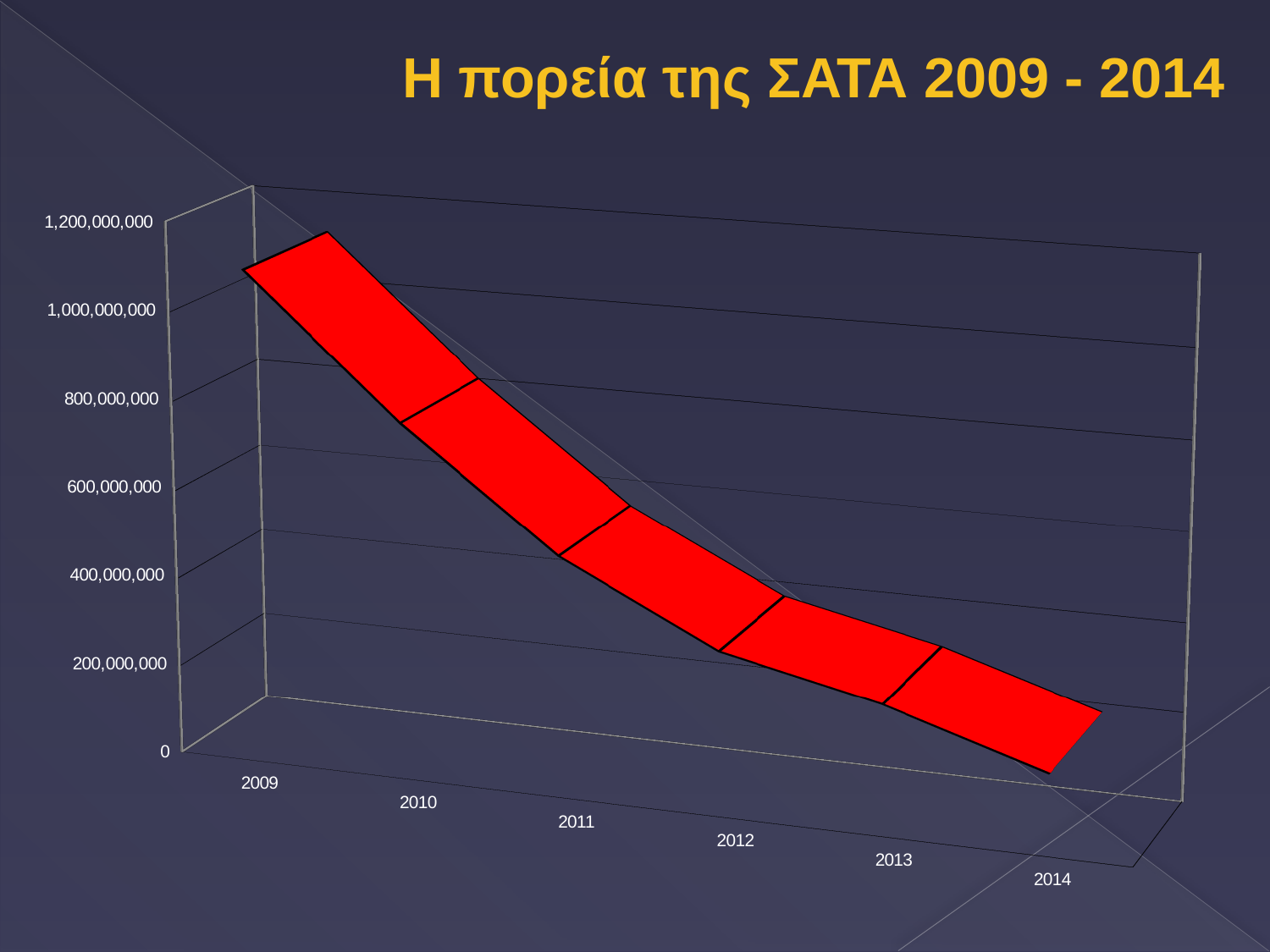
Is the value for 2012 greater or less than 600,000,000? less Which is larger, the value for 2010 or the value for 2013? 2010 Is the value for 2011 greater or less than 1,000,000,000? less Which year has the lowest value? 2014 Do the values rise or fall from 2009 to 2014? fall What kind of chart is shown on the slide? line chart Is the value for 2009 greater or less than 800,000,000? greater What is the title of the chart? Η πορεία της ΣΑΤΑ 2009 - 2014 Which year has the highest value? 2009 What is the highest value shown on the vertical axis? 1,200,000,000 How many years are plotted on the x axis? 6